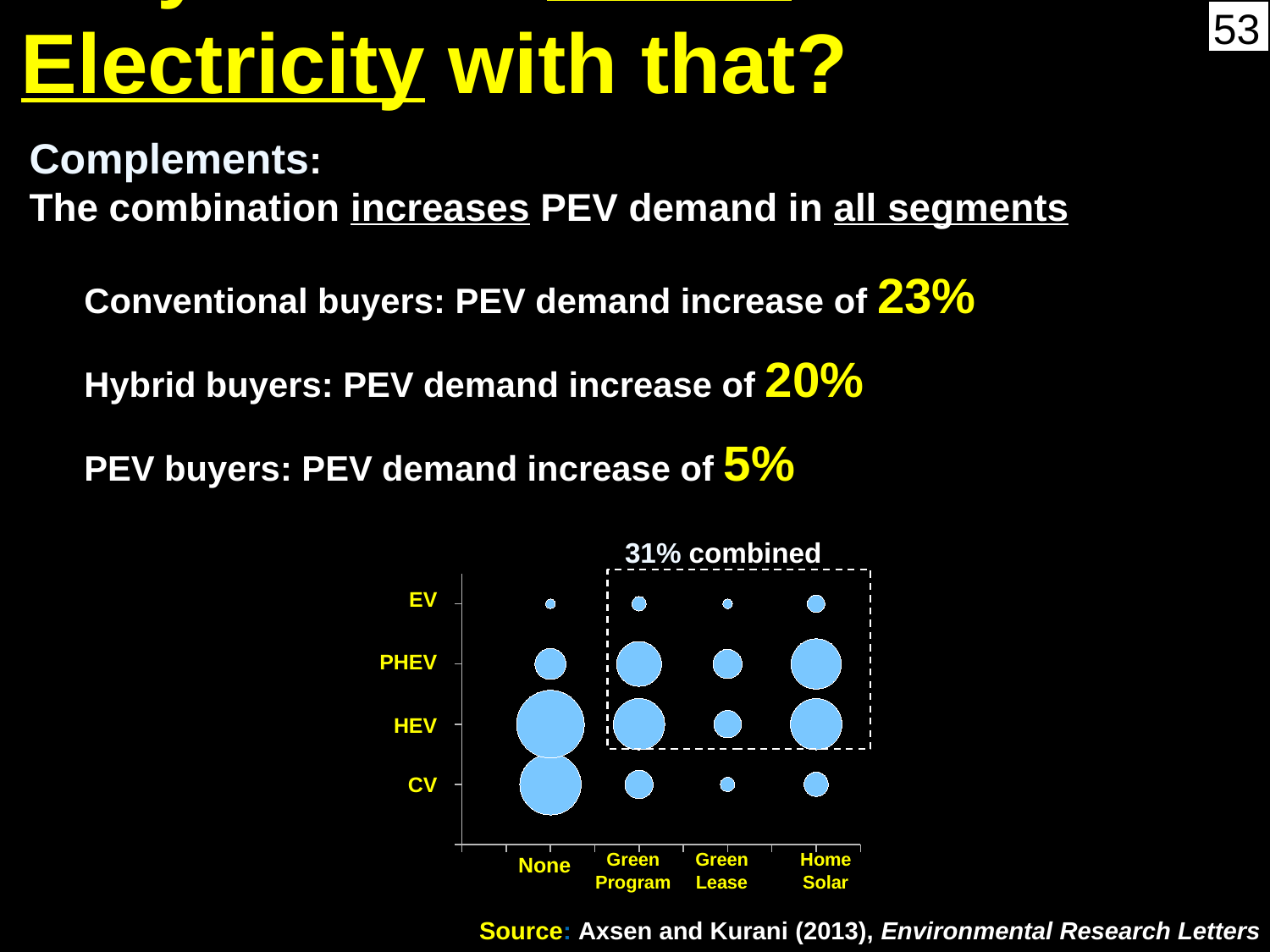
In the PHEV row, which bubble is larger: Home Solar or Green Lease? Home Solar How many vehicle types are listed along the y axis of the chart? 4 Which x-axis category has the smallest bubble in the HEV row? Green Lease In the EV row, which bubble is larger: Home Solar or Green Lease? Home Solar What label is printed above the dashed box on the chart? 31% combined Which x-axis category has the smallest bubble in the CV row? Green Lease Which x-axis category has the largest bubble in the CV row? None What kind of chart is shown on the slide? Bubble chart In the HEV row, which bubble is larger: None or Green Lease? None Which x-axis categories are enclosed by the dashed box on the chart? Green Program, Green Lease, Home Solar How many categories are shown along the x axis of the chart? 4